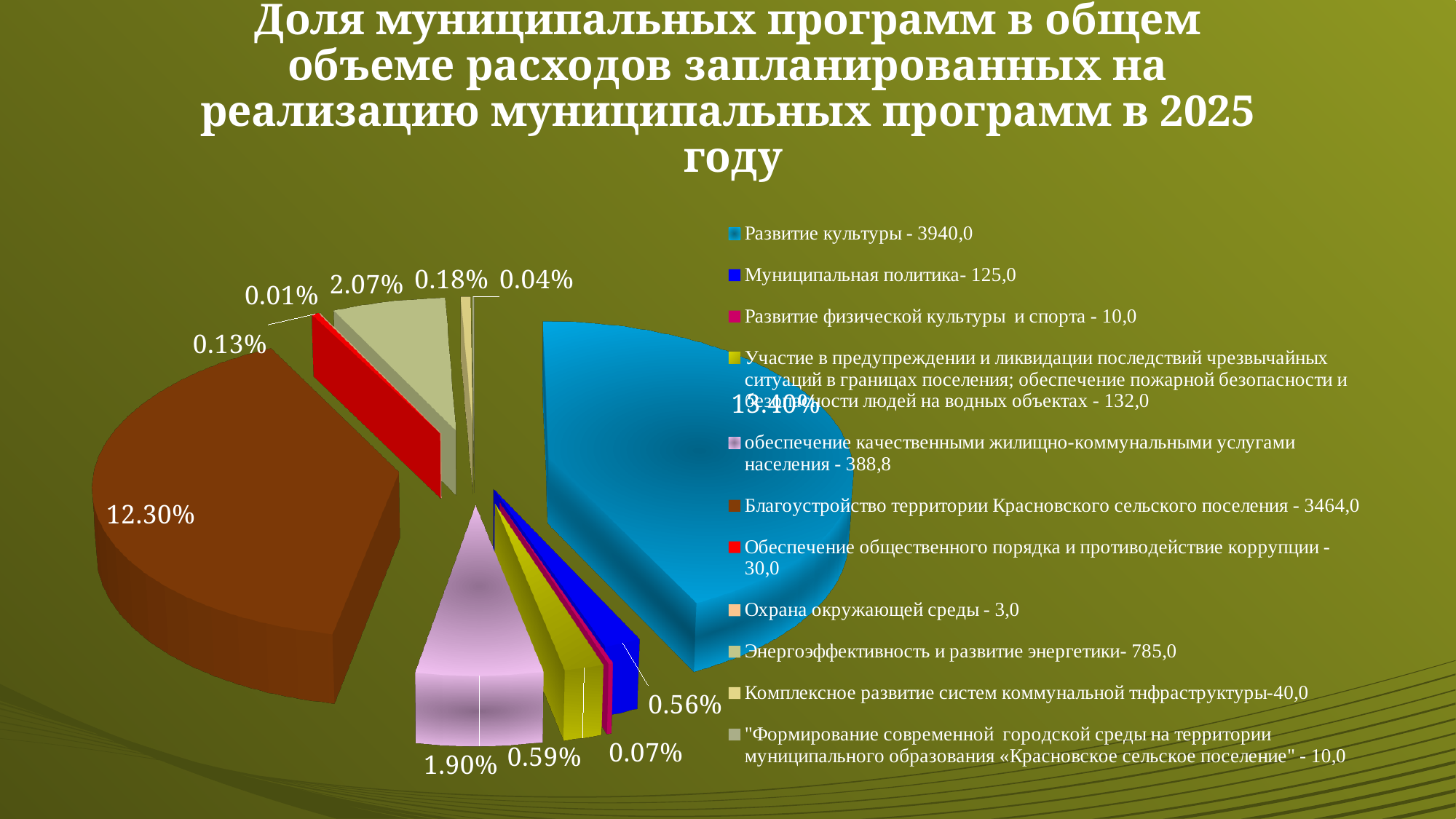
What is the difference between the share for "Благоустройство территории" (12.30%) and the share for "обеспечение качественными жилищно-коммунальными услугами населения" (1.90%)? 10.40% What share is shown for "обеспечение качественными жилищно-коммунальными услугами населения"? 1.90% What share is shown for "Участие в предупреждении и ликвидации последствий чрезвычайных ситуаций..."? 0.59% What share is shown for "Благоустройство территории Красновского сельского поселения"? 12.30% What share is shown for "Муниципальная политика"? 0.56% Which is larger: the share for "Благоустройство территории" or the share for "обеспечение качественными жилищно-коммунальными услугами населения"? Благоустройство территории How many categories does the legend of the pie chart list? 11 What share is shown for "Развитие физической культуры и спорта"? 0.07% What amount is given in the legend entry for "Развитие культуры"? 3940,0 Which category has the largest slice of the pie? Развитие культуры What colour is the slice for "Благоустройство территории Красновского сельского поселения"? brown What kind of chart is shown on the slide? pie chart